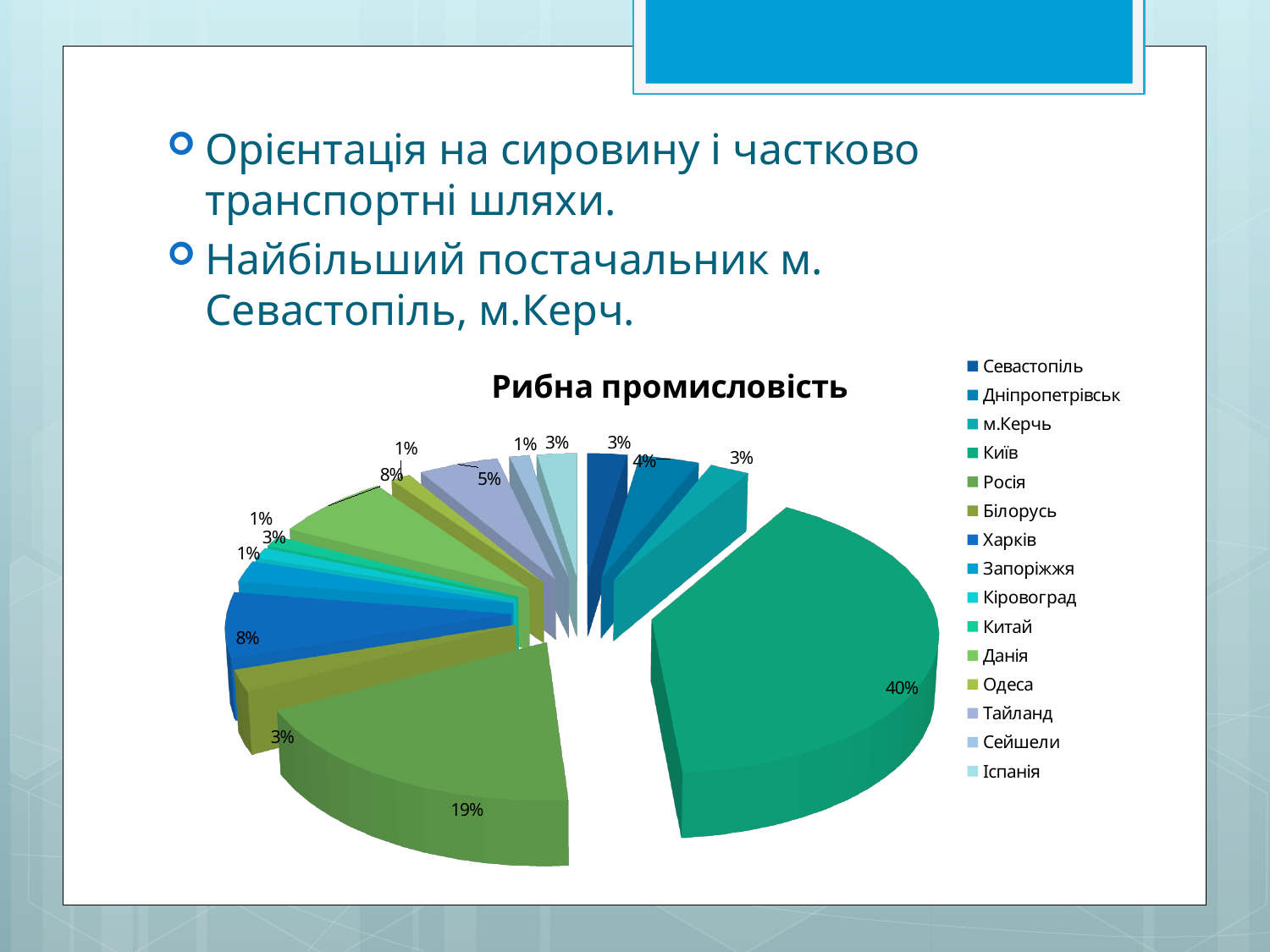
What is the difference in percentage points between the Київ slice and the Росія slice? 21 What share of the pie does Київ have? 40% What is the value shown for Харків? 8% What share of the pie does Росія have? 19% What is the title of the chart? Рибна промисловість What is the value shown for Тайланд? 5% How many entries does the chart's legend list? 15 What kind of chart is shown on the slide? pie chart Which category has the largest slice of the pie? Київ Which is larger, the slice for Росія or the slice for Харків? Росія Which is larger, the slice for Київ or the slice for Росія? Київ What is the value shown for Данія? 8%